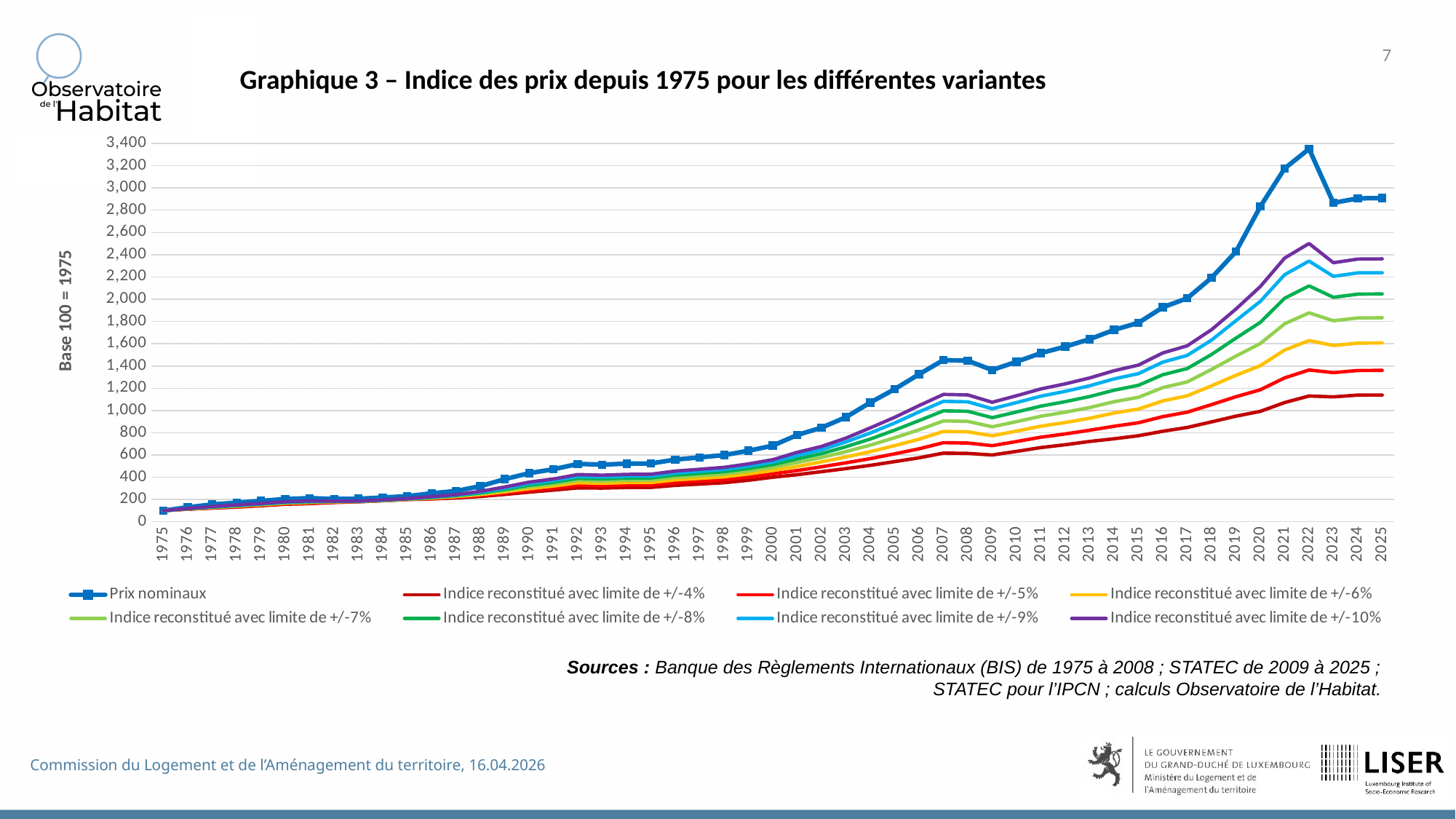
Does the Prix nominaux series rise or fall between 2022 and 2023? fall Is the value of Indice reconstitué avec limite de +/-4% in 2025 greater or less than 1,200? less Is the value of Prix nominaux in 2023 greater or less than 3,000? less What is the title of the chart? Graphique 3 – Indice des prix depuis 1975 pour les différentes variantes Is the value of Prix nominaux in 2022 greater or less than 3,200? greater In which year does the Prix nominaux series reach its peak? 2022 How many years are plotted along the x axis? 51 Which series has the highest value in 2022? Prix nominaux Which series has the lowest value in 2025? Indice reconstitué avec limite de +/-4% How many series does the legend list? 8 What kind of chart is shown on the slide? line chart What is the label of the vertical axis? Base 100 = 1975